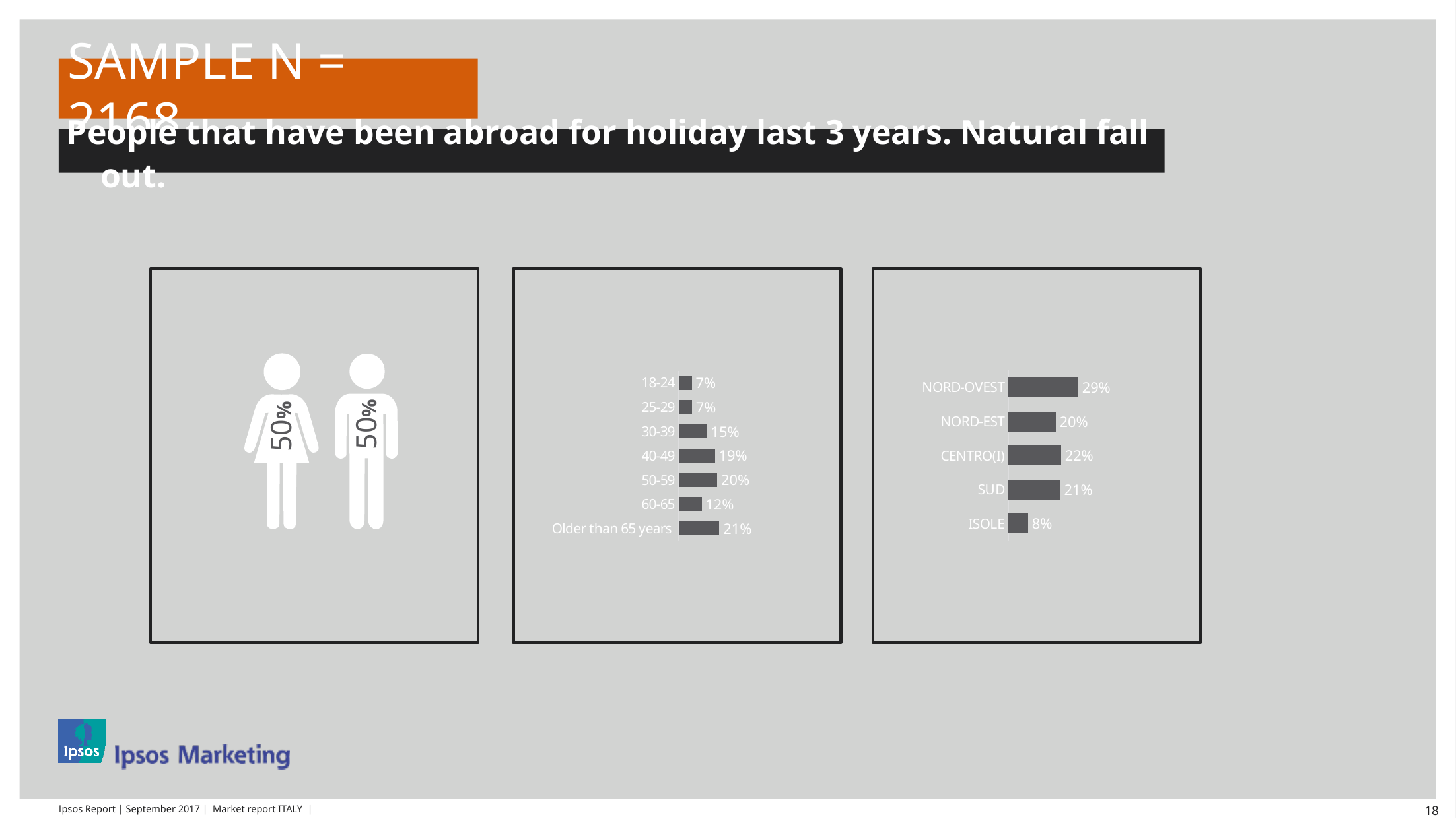
In the middle chart (age groups), what is the difference between the 50-59 group and the 60-65 group? 8% In the right chart (regions), what is the value for ISOLE? 8% In the middle chart (age groups), which is larger, the value for 30-39 or the value for 60-65? 30-39 In the right chart (regions), what is the difference between NORD-OVEST and NORD-EST? 9% What kind of chart is the right chart showing the regions? Bar chart In the middle chart (age groups), what is the value for Older than 65 years? 21% In the right chart (regions), which region has the highest value? NORD-OVEST In the right chart (regions), which region has the lowest value? ISOLE In the right chart (regions), what is the value for NORD-OVEST? 29% In the middle chart (age groups), what is the value for the 40-49 group? 19% In the middle chart (age groups), which age group has the highest value? Older than 65 years In the middle chart (age groups), how many age categories are shown? 7